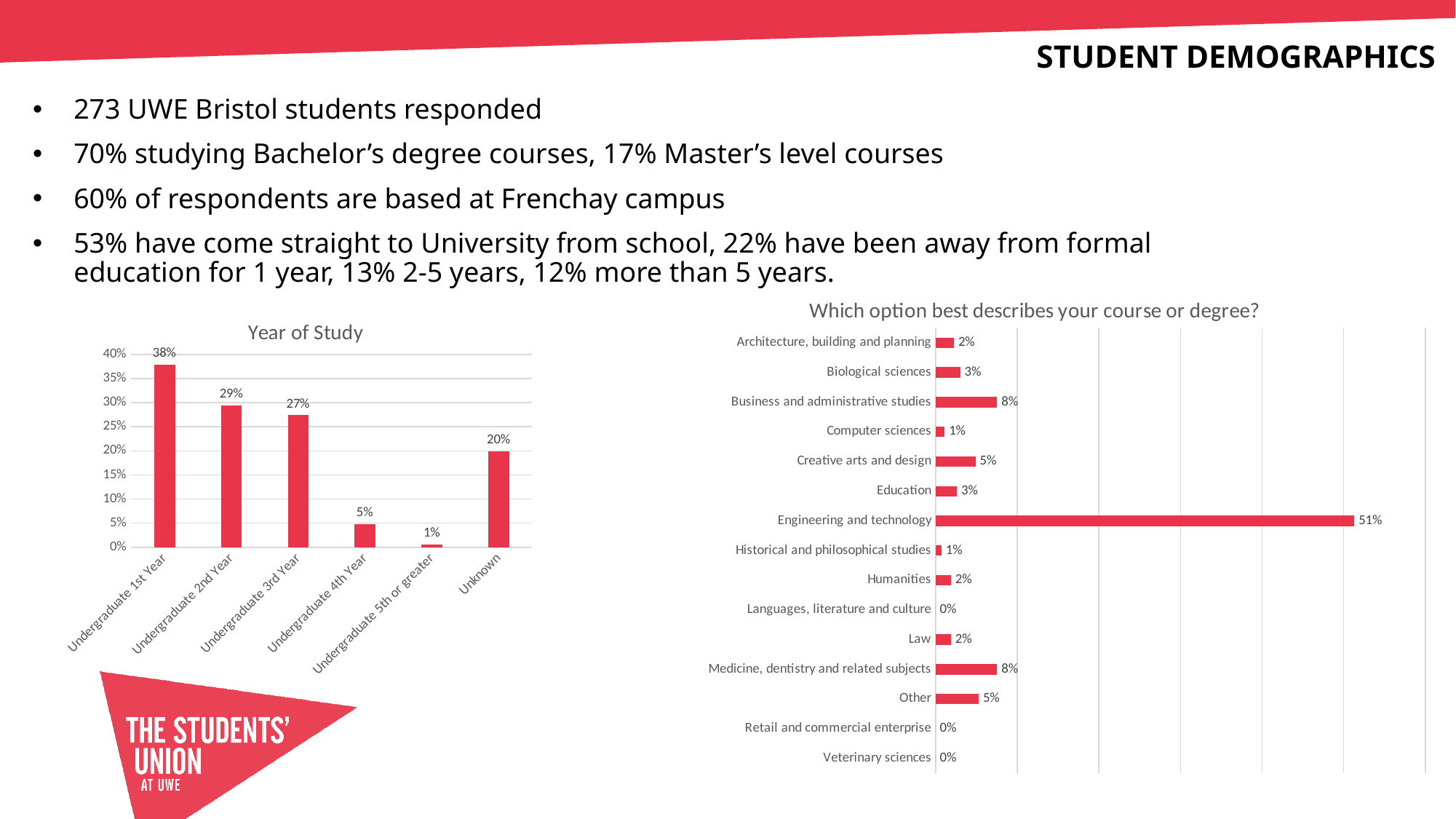
In the 'Year of Study' chart, what is the value for Unknown? 20% In the 'Year of Study' chart, what is the difference between Undergraduate 2nd Year and Undergraduate 3rd Year? 2% In the 'Year of Study' chart, which is larger: Undergraduate 4th Year or Unknown? Unknown In the 'Which option best describes your course or degree?' chart, which category has the highest value? Engineering and technology In the 'Year of Study' chart, which category has the lowest value? Undergraduate 5th or greater In the 'Year of Study' chart, how many categories are shown on the x axis? 6 In the 'Which option best describes your course or degree?' chart, how many categories are listed? 15 In the 'Which option best describes your course or degree?' chart, what is the difference between Business and administrative studies and Biological sciences? 5% In the 'Year of Study' chart, what is the value for Undergraduate 1st Year? 38% In the 'Which option best describes your course or degree?' chart, what is the value for Creative arts and design? 5% What type of chart is the 'Which option best describes your course or degree?' chart? Bar chart In the 'Which option best describes your course or degree?' chart, what is the value for Engineering and technology? 51%